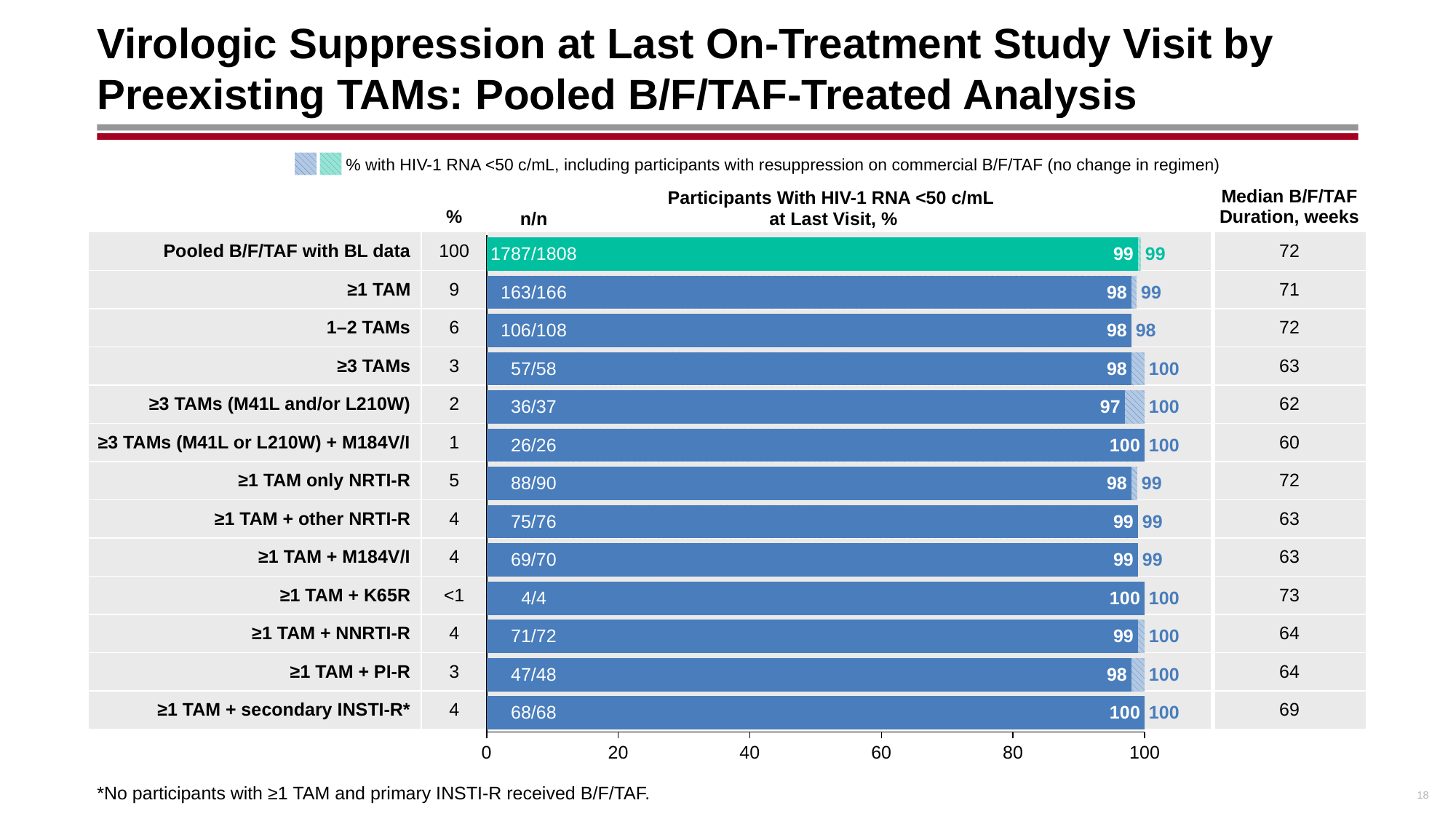
How many categories (rows) are plotted in the bar chart? 13 Which has a larger solid bar value: ≥1 TAM + M184V/I or 1–2 TAMs? ≥1 TAM + M184V/I What is the value including participants with resuppression (the blue label) for the ≥3 TAMs group? 100 What is the median B/F/TAF duration in weeks for the ≥1 TAM + K65R group? 73 Is the solid bar value for the ≥1 TAM group greater or less than 80? greater What is the difference between the solid bar values for ≥1 TAM + K65R and ≥3 TAMs (M41L and/or L210W)? 3 Which category has the lowest solid bar value for participants with HIV-1 RNA <50 c/mL at last visit? ≥3 TAMs (M41L and/or L210W) What kind of chart is shown on the slide? bar chart What is the n/n shown for the Pooled B/F/TAF with BL data row? 1787/1808 What is the maximum value shown on the x axis of the chart? 100 What is the solid bar value for the ≥1 TAM + PI-R group? 98 What is the percentage of participants with HIV-1 RNA <50 c/mL at last visit (solid bar value) for the ≥3 TAMs (M41L and/or L210W) group? 97